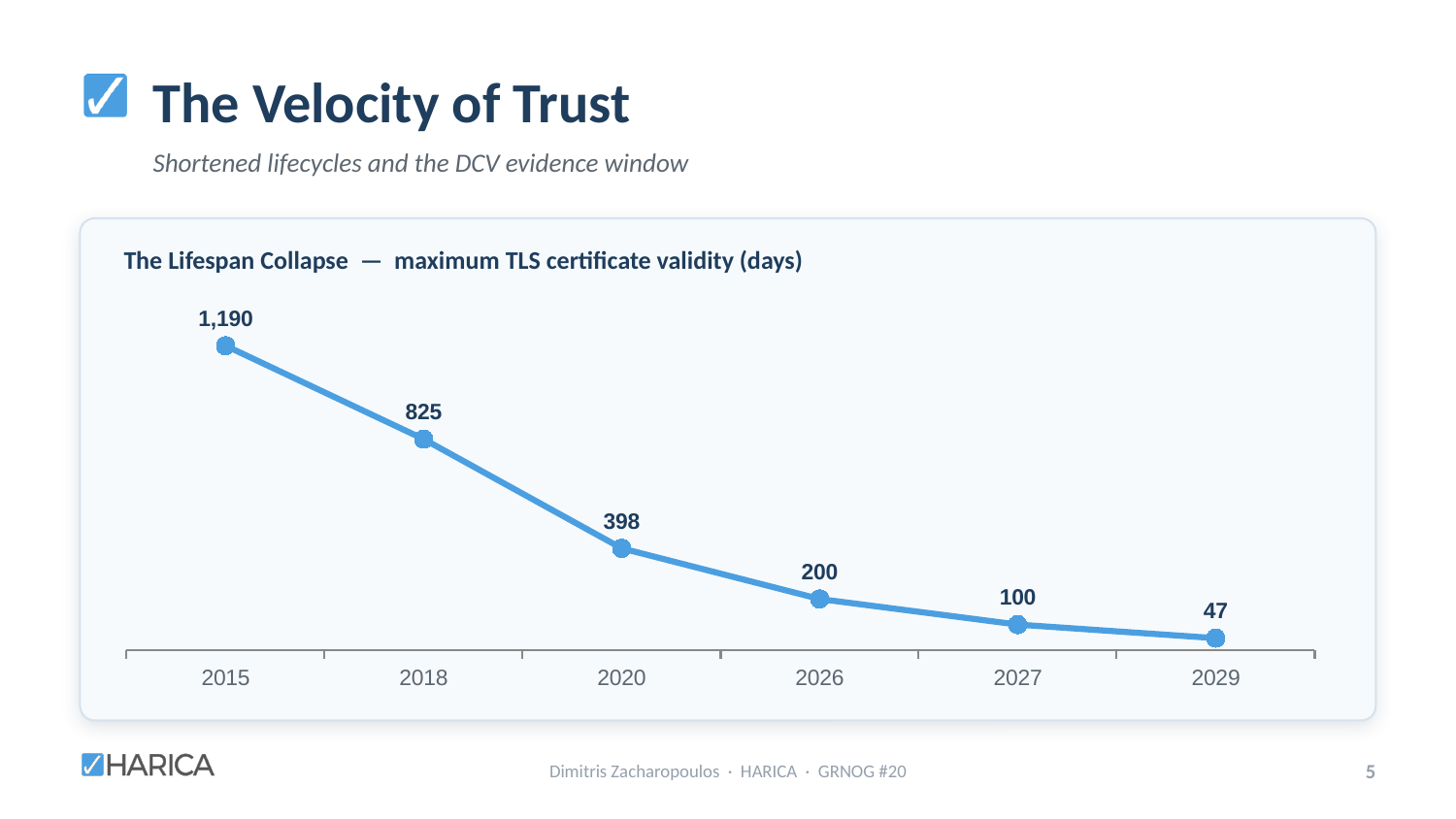
What is the maximum TLS certificate validity in days for 2020? 398 What is the difference in days between the 2018 and 2026 values? 625 Do the values rise or fall from 2015 to 2029? fall What is the maximum TLS certificate validity in days for 2027? 100 What is the maximum TLS certificate validity in days for 2015? 1,190 Which year has the highest maximum TLS certificate validity? 2015 How many years are plotted on the chart? 6 What is the maximum TLS certificate validity in days for 2029? 47 Which year has the lowest maximum TLS certificate validity? 2029 What is the title of the chart? The Lifespan Collapse — maximum TLS certificate validity (days) What kind of chart is shown on the slide? line chart Which is larger, the value for 2020 or the value for 2026? 2020